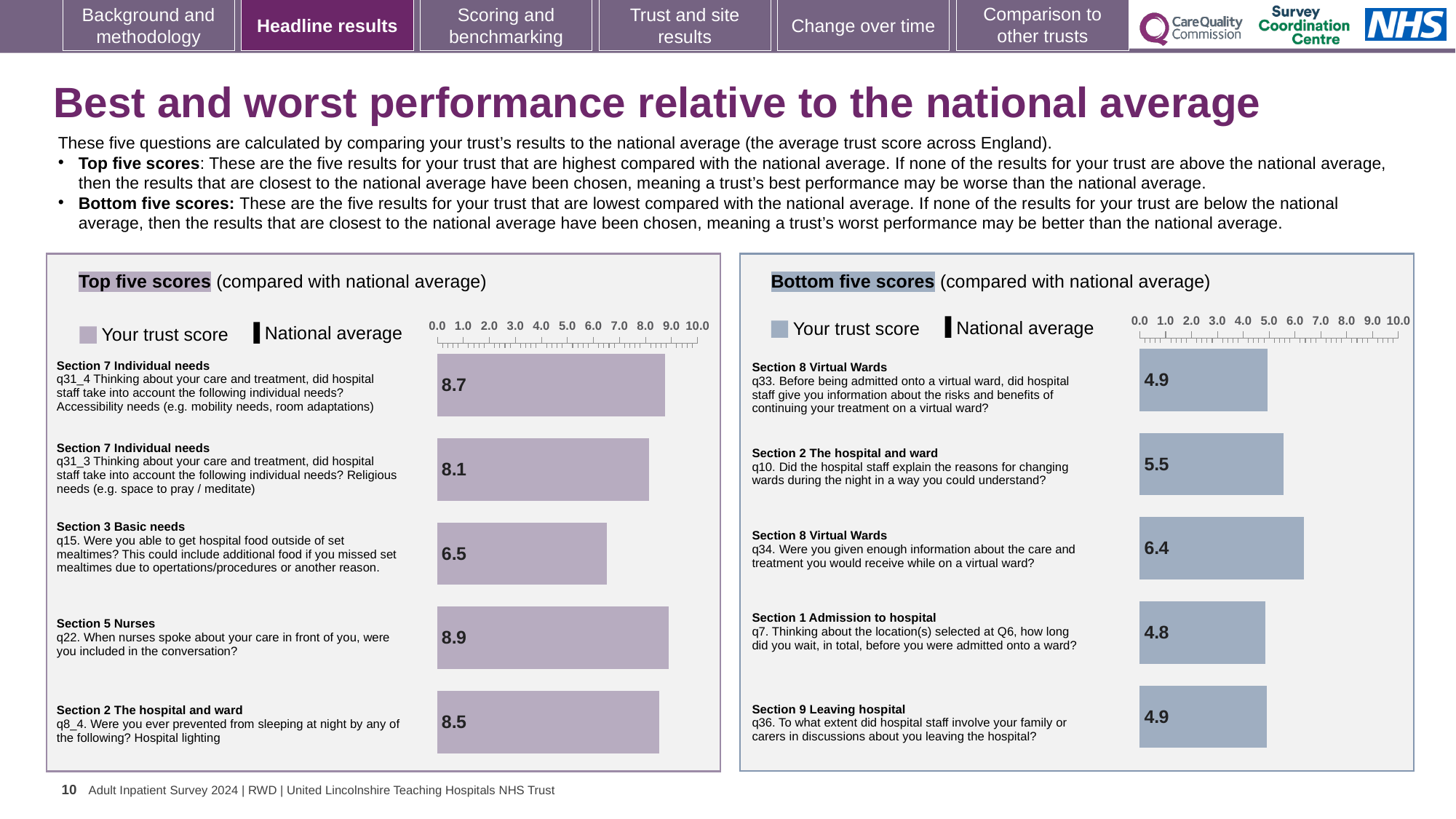
How many entries does the legend of the Bottom five scores chart list? 2 In the Top five scores chart, which question has the highest trust score? q22 (8.9) In the Top five scores chart, what is the trust score for q22 (When nurses spoke about your care in front of you, were you included in the conversation?)? 8.9 In the Bottom five scores chart, what is the trust score for q34 (Were you given enough information about the care and treatment you would receive while on a virtual ward?)? 6.4 In the Top five scores chart, which question has the lowest trust score? q15 (6.5) In the Bottom five scores chart, what is the difference between the trust scores for q10 (explain the reasons for changing wards) and q7 (how long did you wait before being admitted onto a ward)? 0.7 What kind of chart is the Top five scores chart? Bar chart In the Bottom five scores chart, which question has the lowest trust score? q7 (4.8) How many bars are plotted in the Bottom five scores chart? 5 In the Bottom five scores chart, which question has the highest trust score? q34 (6.4) In the Top five scores chart, which has the larger trust score: q8_4 (Hospital lighting) or q31_3 (Religious needs)? q8_4 (Hospital lighting) In the Top five scores chart, what is the difference between the trust scores for q31_4 (Accessibility needs) and q31_3 (Religious needs)? 0.6